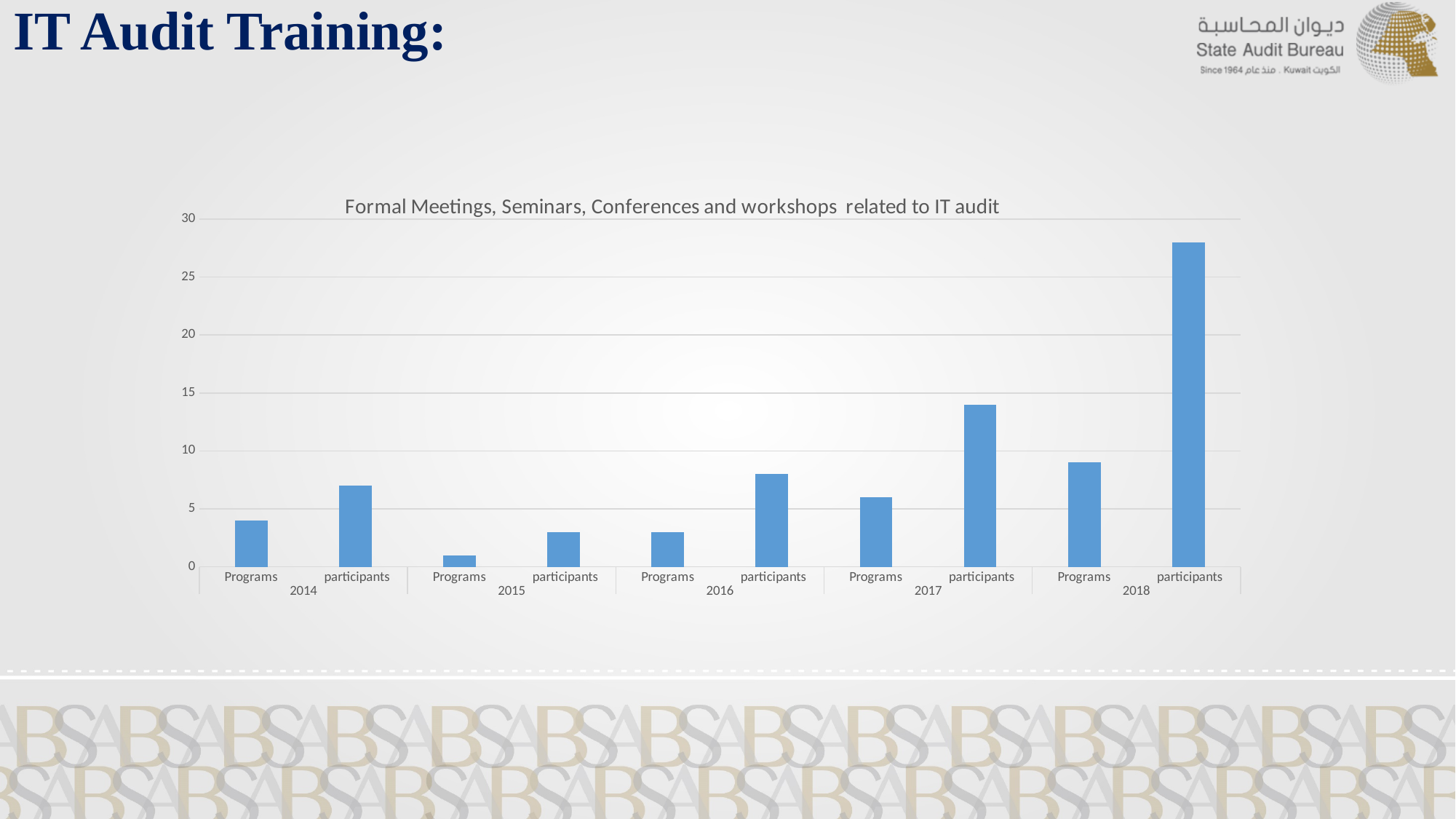
Is the value for participants in 2014 greater or less than 5? greater Which bar is the highest in the chart? participants 2018 Which bar is the lowest in the chart? Programs 2015 What kind of chart is shown on the slide? bar chart How many bars are plotted in the chart? 10 How many years are shown along the x axis of the chart? 5 Is the value for Programs in 2015 greater or less than 5? less Is the value for participants in 2018 greater or less than 25? greater What is the title of the chart? Formal Meetings, Seminars, Conferences and workshops related to IT audit Which is larger: participants in 2017 or participants in 2016? participants in 2017 From 2015 to 2018, do the participants values rise or fall? rise